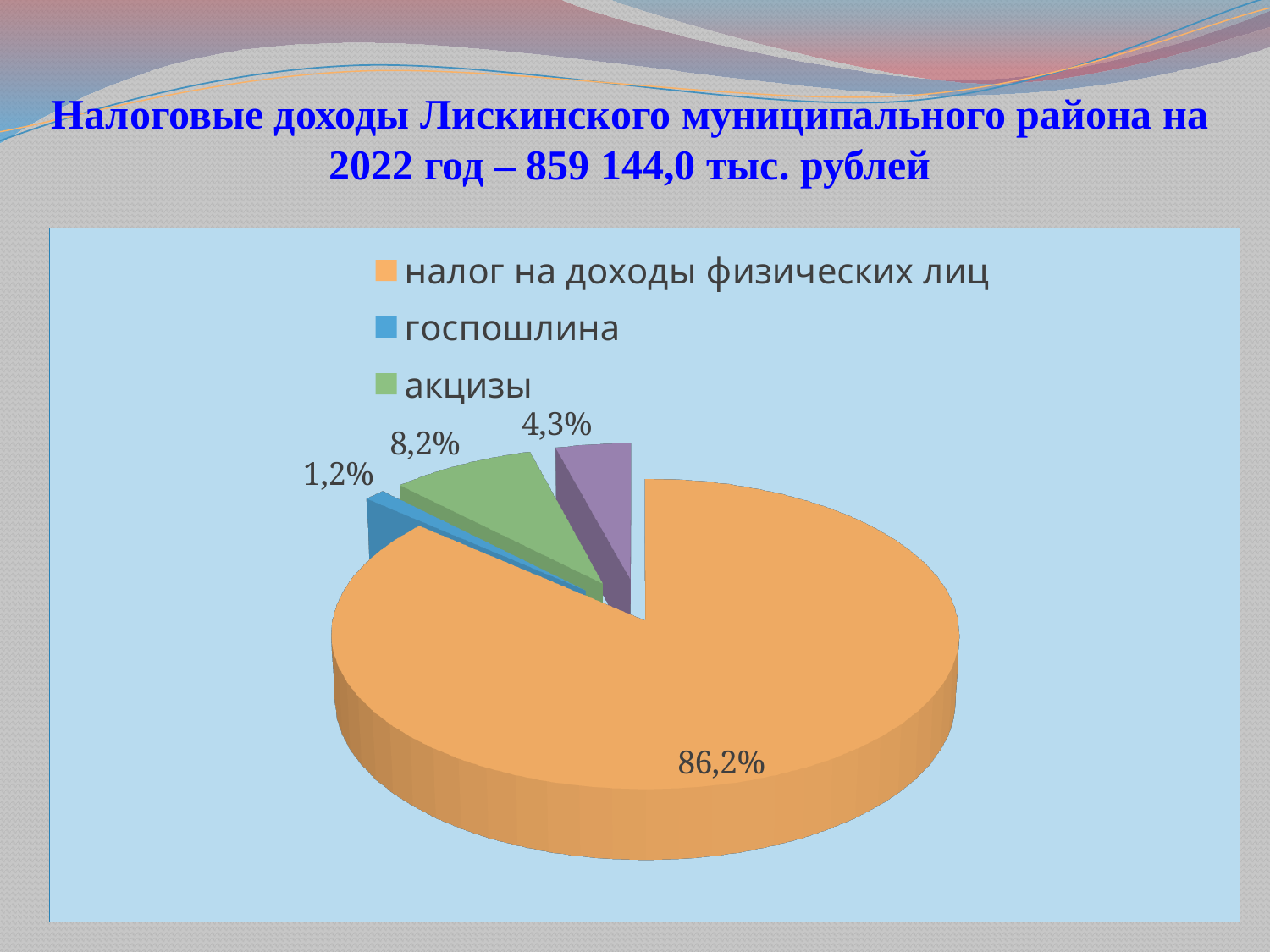
How many entries does the legend list? 3 Which category has the largest slice of the pie? налог на доходы физических лиц What share of the pie does налог на доходы физических лиц account for? 86,2% Which category has the smallest slice of the pie? госпошлина How many slices does the pie chart have? 4 What kind of chart is shown on the slide? pie chart What share of the pie does госпошлина account for? 1,2% What share of the pie does акцизы account for? 8,2% By how many percentage points does the share for акцизы exceed the share for госпошлина? 7,0% By how many percentage points does the share for налог на доходы физических лиц exceed the share for акцизы? 78,0% According to the slide title, what is the total tax revenue of the Лискинский municipal district for 2022? 859 144,0 тыс. рублей Which is larger, the share for акцизы or the share for госпошлина? акцизы